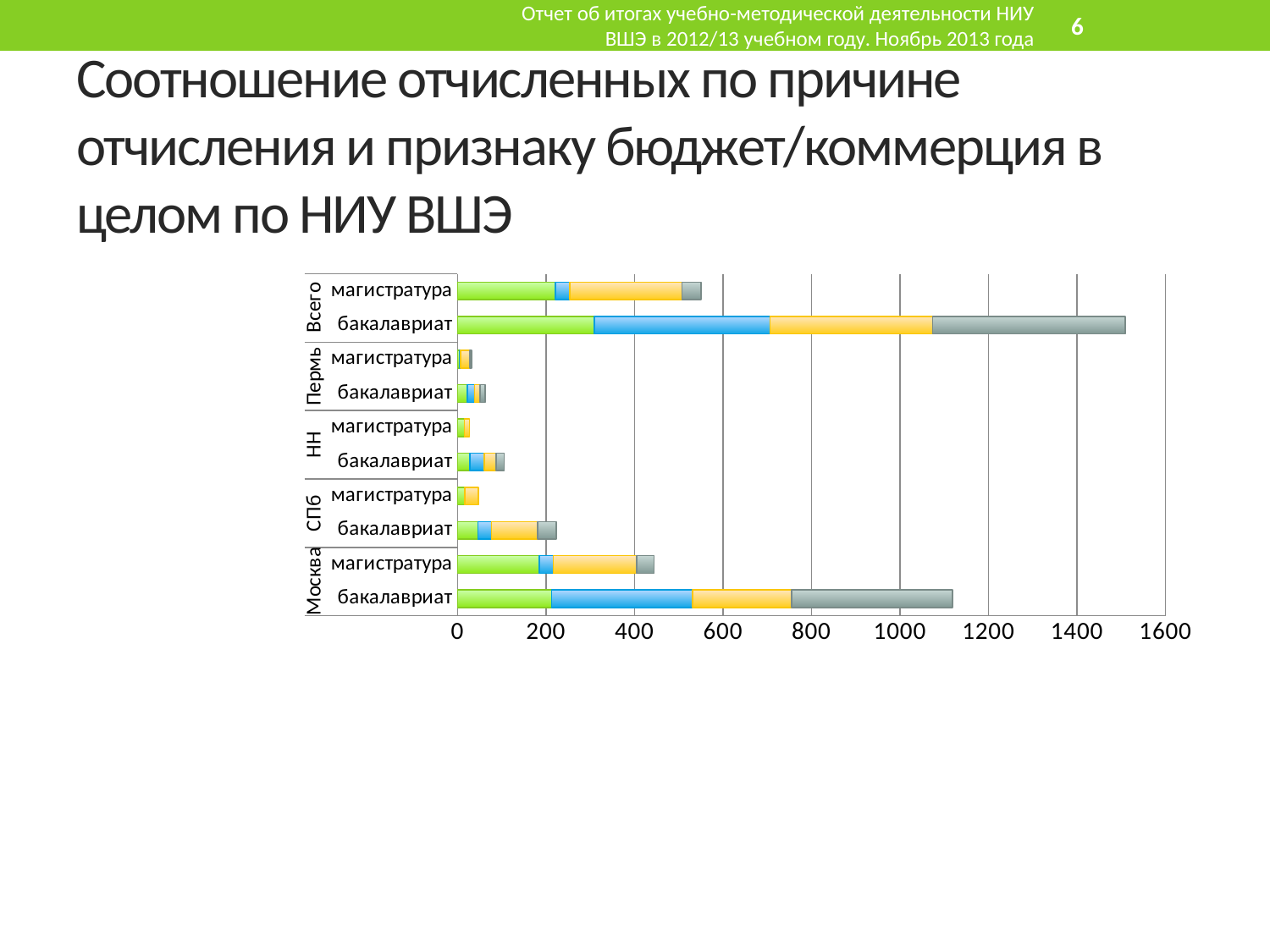
Is the total value for Всего магистратура greater or less than 400? greater Which bar is the longest in the chart? Всего бакалавриат Which bar is longer: Москва бакалавриат or СПб бакалавриат? Москва бакалавриат How many bars are plotted in the chart? 10 Among the бакалавриат bars of the individual campuses (Москва, СПб, НН, Пермь), which is the shortest? Пермь What is the maximum value shown on the horizontal axis? 1600 Is the total value for Всего бакалавриат greater or less than 1400? greater What kind of chart is shown on the slide? bar chart Is the total value for Москва бакалавриат greater or less than 1000? greater How many campus groups (Москва, СПб, НН, Пермь, Всего) are shown on the vertical axis? 5